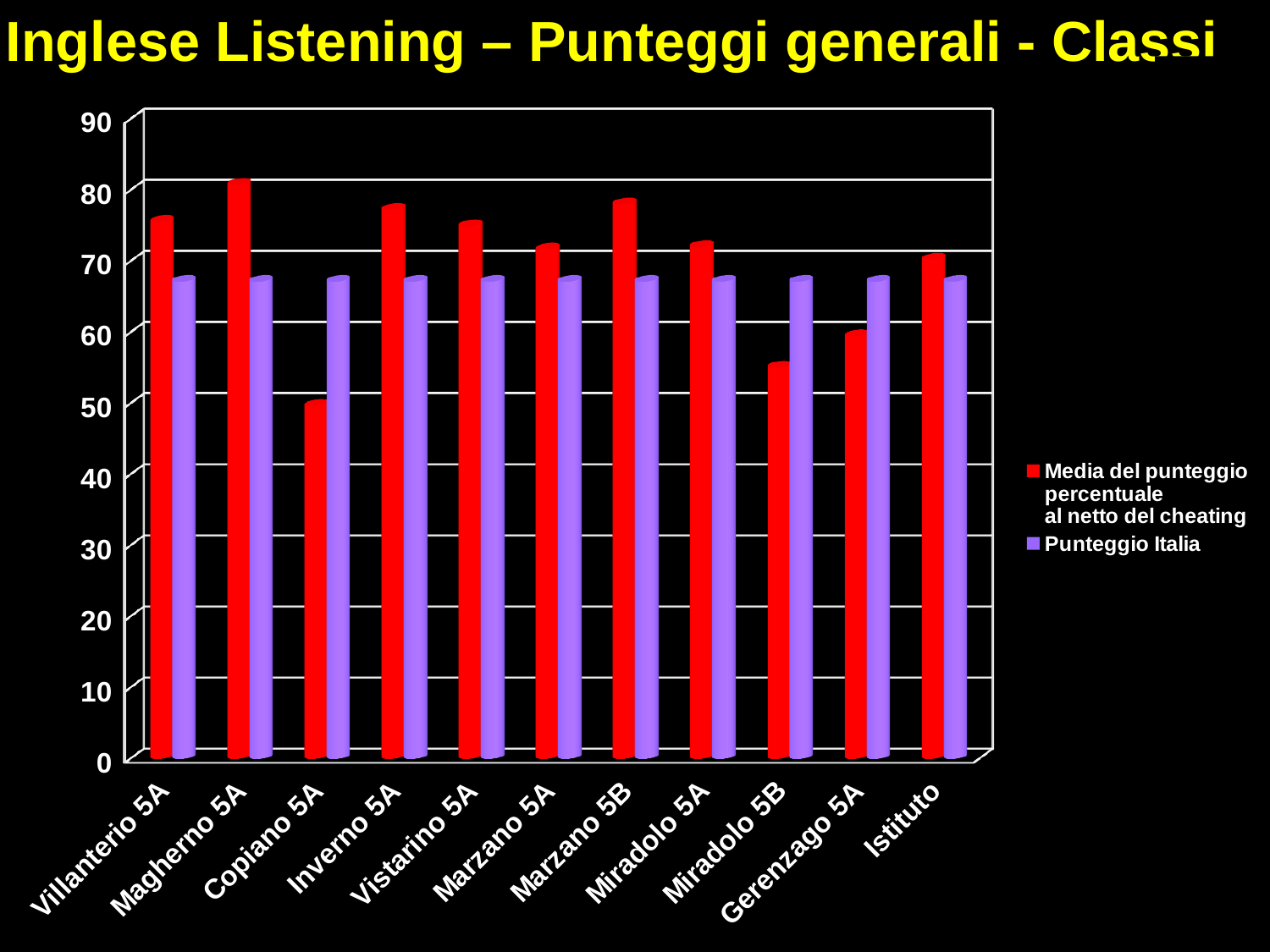
How many series does the legend list? 2 Which category has the highest value for 'Media del punteggio percentuale al netto del cheating'? Magherno 5A Which category has the lowest value for 'Media del punteggio percentuale al netto del cheating'? Copiano 5A Is the 'Media del punteggio percentuale al netto del cheating' value for Villanterio 5A greater or less than 70? greater For Magherno 5A, which is larger: 'Media del punteggio percentuale al netto del cheating' or 'Punteggio Italia'? Media del punteggio percentuale al netto del cheating Is the 'Media del punteggio percentuale al netto del cheating' value for Copiano 5A greater or less than 60? less For Copiano 5A, which is larger: 'Media del punteggio percentuale al netto del cheating' or 'Punteggio Italia'? Punteggio Italia What kind of chart is shown on the slide? bar chart What colour are the bars for the 'Punteggio Italia' series? purple How many categories are shown along the x axis? 11 Is the 'Media del punteggio percentuale al netto del cheating' value for Miradolo 5B greater or less than 60? less